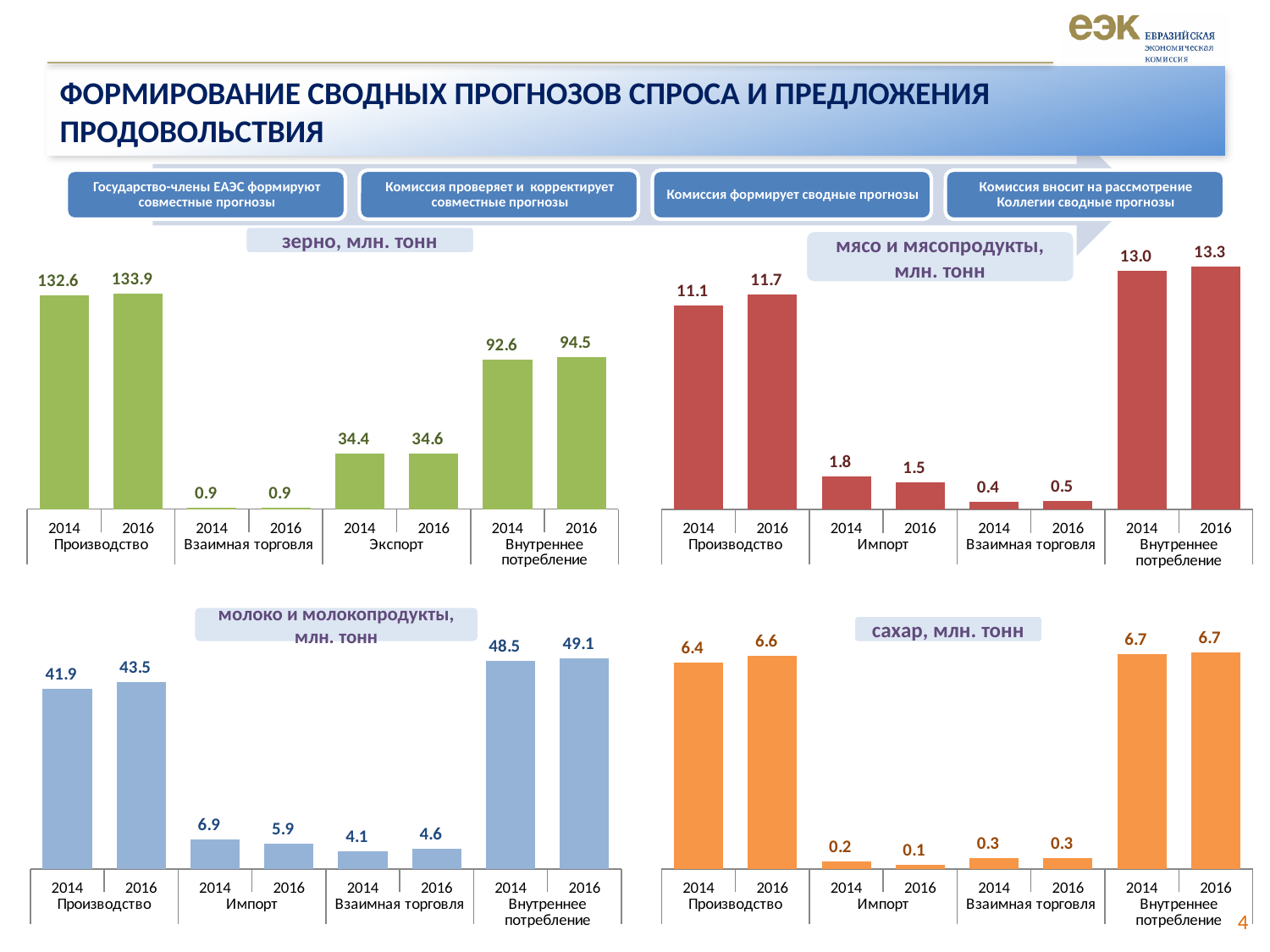
In the 'зерно, млн. тонн' chart, what is the value for Производство in 2014? 132.6 In the 'зерно, млн. тонн' chart, what is the difference between Внутреннее потребление in 2016 and in 2014? 1.9 In the 'молоко и молокопродукты, млн. тонн' chart, what is the value for Внутреннее потребление in 2016? 49.1 What type of chart is the 'сахар, млн. тонн' chart? Bar chart In the 'молоко и молокопродукты, млн. тонн' chart, which is larger: Импорт in 2014 or Импорт in 2016? Импорт in 2014 In the 'мясо и мясопродукты, млн. тонн' chart, which bar is the highest? Внутреннее потребление 2016 In the 'сахар, млн. тонн' chart, how many bars are plotted? 8 In the 'мясо и мясопродукты, млн. тонн' chart, which bar is the lowest? Взаимная торговля 2014 In the 'молоко и молокопродукты, млн. тонн' chart, what is the difference between Производство in 2016 and in 2014? 1.6 In the 'мясо и мясопродукты, млн. тонн' chart, what is the value for Импорт in 2014? 1.8 In the 'сахар, млн. тонн' chart, what is the value for Импорт in 2016? 0.1 In the 'зерно, млн. тонн' chart, what is the value for Экспорт in 2016? 34.6